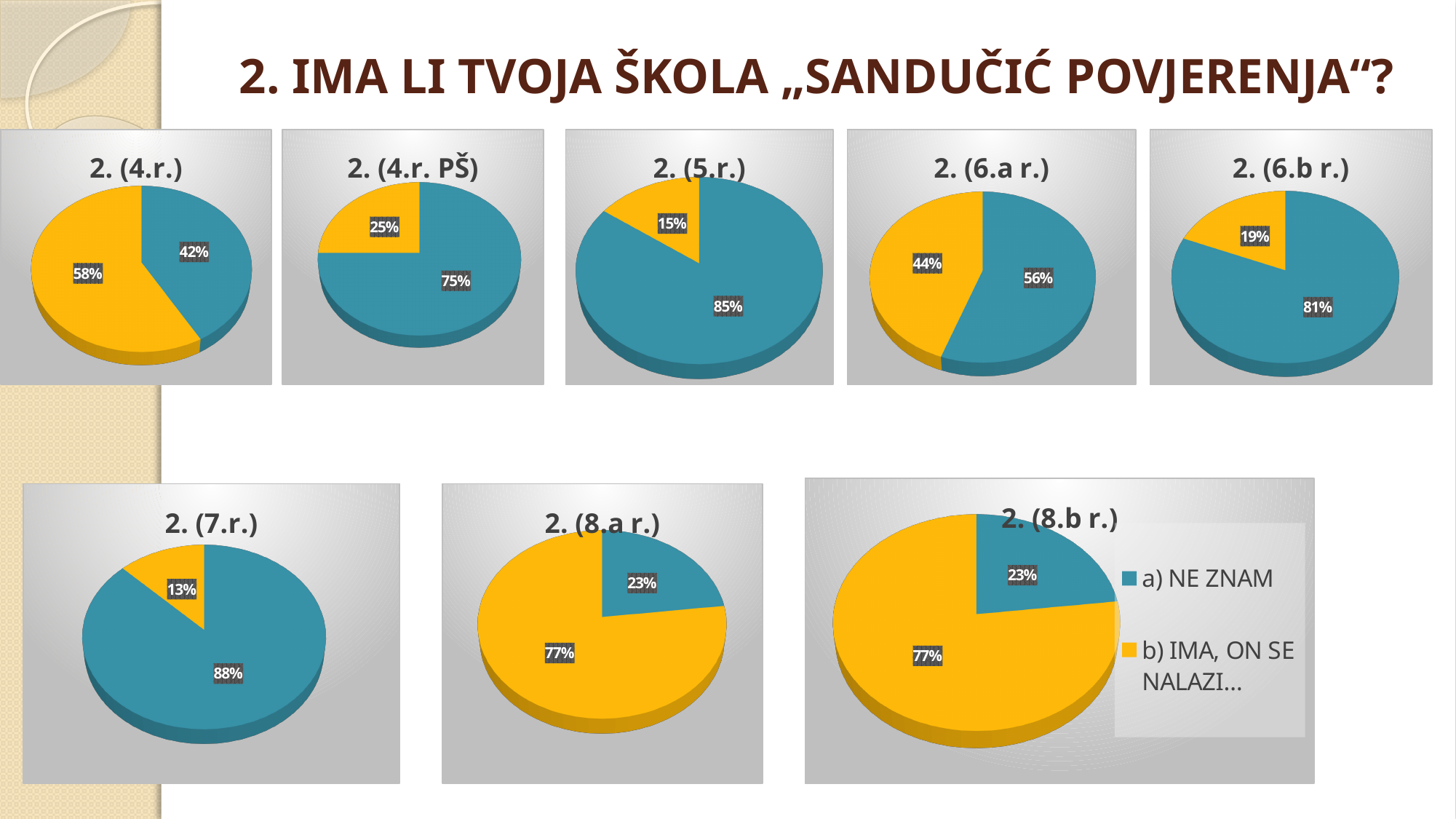
In the chart titled "2. (5.r.)", what is the share of the largest slice? 85% How many entries does the legend on the chart titled "2. (8.b r.)" list? 2 In the chart titled "2. (6.a r.)", which slice is larger, the teal one or the yellow one? the teal one (56%) In the chart titled "2. (7.r.)", what percentage is shown for the yellow slice? 13% In the chart titled "2. (4.r.)", what percentage is shown for the teal slice (a) NE ZNAM)? 42% How many slices does the chart titled "2. (4.r.)" have? 2 In the chart titled "2. (4.r. PŠ)", what percentage is shown for the yellow slice? 25% In the chart titled "2. (8.b r.)", which legend entry corresponds to the teal colour? a) NE ZNAM In the chart titled "2. (8.b r.)", what is the share of the slice labelled b) IMA, ON SE NALAZI...? 77% What kind of chart is used for "2. (7.r.)"? pie chart In the chart titled "2. (8.a r.)", what percentage is shown for the teal slice (a) NE ZNAM)? 23% In the chart titled "2. (6.b r.)", what is the difference between the two slices? 62 percentage points